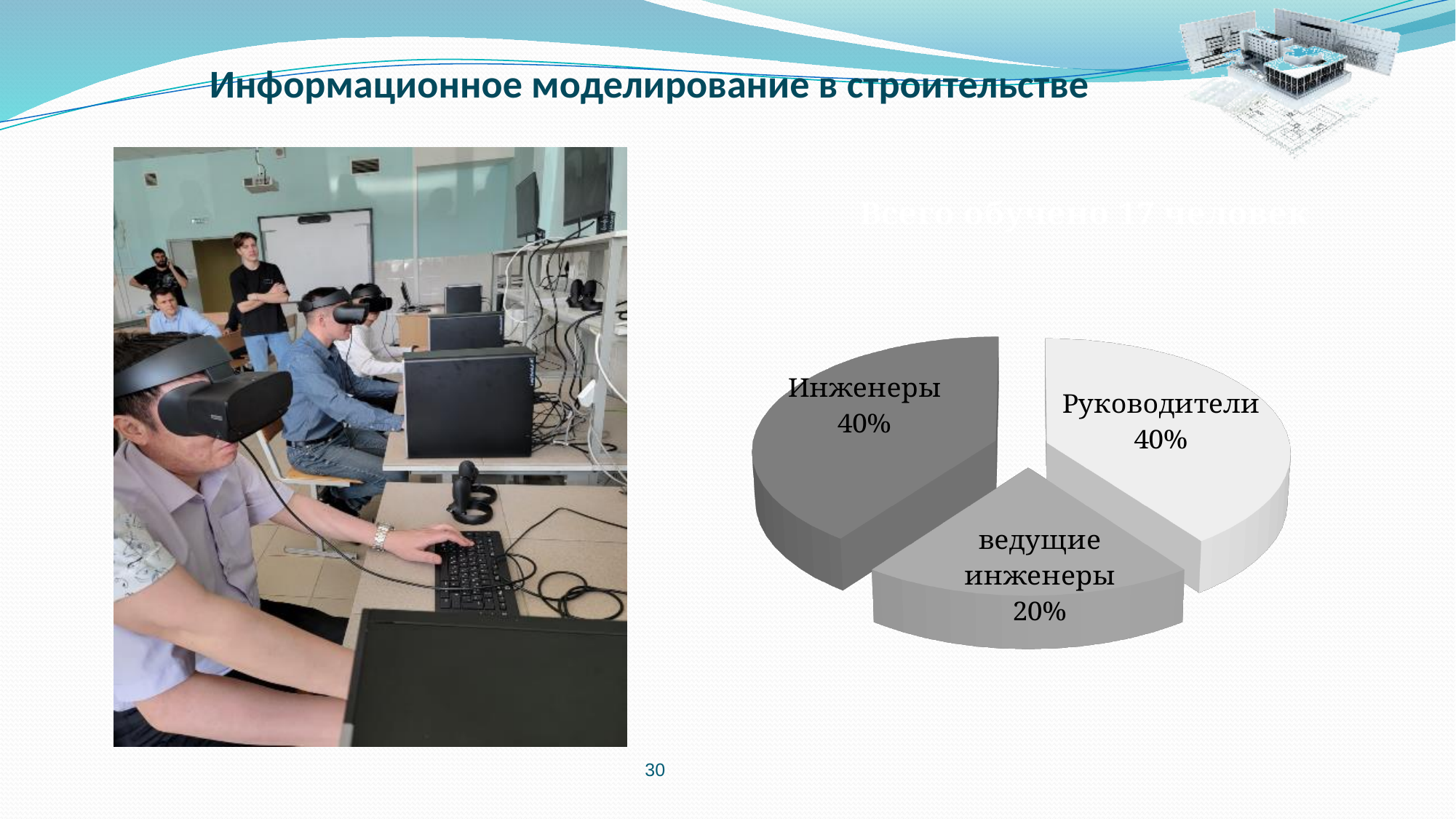
How many slices does the pie chart have? 3 What share of the pie chart is labelled ведущие инженеры? 20% What share of the pie chart is labelled Инженеры? 40% Which slice of the pie chart is the lightest in colour? Руководители What kind of chart is shown on the slide? pie chart Which category has the smallest slice in the pie chart? ведущие инженеры Which slice is larger, Руководители or ведущие инженеры? Руководители Which slice is larger, Инженеры or ведущие инженеры? Инженеры Do the Инженеры and Руководители slices have the same share of the pie? Yes, both 40% What share of the pie chart is labelled Руководители? 40% Which slice of the pie chart is the darkest in colour? Инженеры By how many percentage points does the Инженеры slice exceed the ведущие инженеры slice? 20